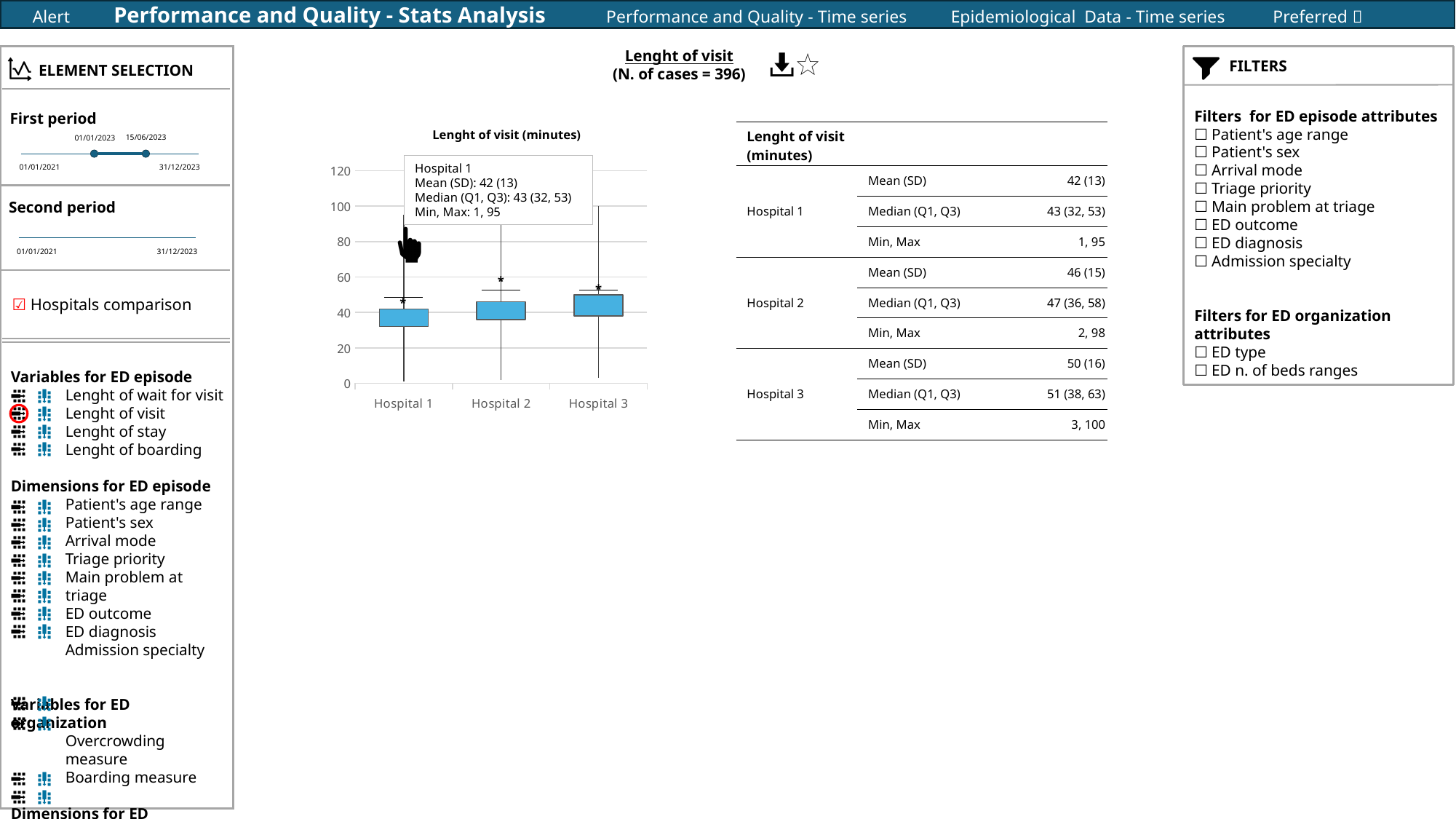
What kind of chart is shown under the title "Lenght of visit (minutes)"? box plot How many hospitals are plotted on the x axis of the "Lenght of visit (minutes)" chart? 3 According to the tooltip on the chart, what are the Min and Max values for Hospital 1? 1, 95 What is the Median (Q1, Q3) of length of visit for Hospital 3 in the table? 51 (38, 63) Which hospital has the lowest mean length of visit? Hospital 1 Which has a larger maximum length of visit, Hospital 2 or Hospital 3? Hospital 3 What is the Mean (SD) of length of visit for Hospital 2 in the table? 46 (15) According to the tooltip on the chart, what is the median length of visit for Hospital 1? 43 Is the top of the box (Q3) for Hospital 1 greater or less than 60 on the y axis? less Which hospital has the highest median length of visit? Hospital 3 What is the difference between the median length of visit for Hospital 3 and Hospital 1? 8 How many cases does the chart heading say are included (N. of cases)? 396